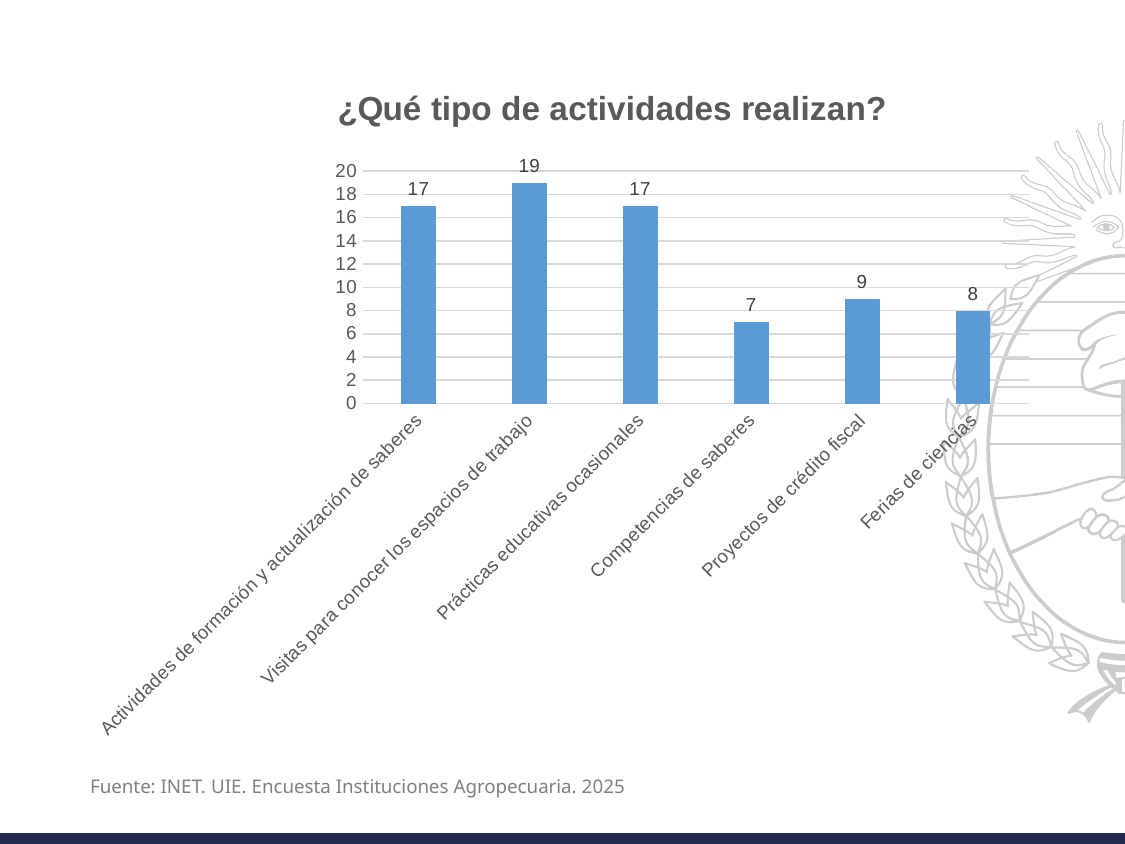
What is the title of the chart? ¿Qué tipo de actividades realizan? What is the value for Visitas para conocer los espacios de trabajo? 19 How many categories are shown in the chart? 6 Which is larger, the value for Proyectos de crédito fiscal or the value for Ferias de ciencias? Proyectos de crédito fiscal What is the value for Proyectos de crédito fiscal? 9 What is the value for Ferias de ciencias? 8 Which category has the highest value? Visitas para conocer los espacios de trabajo Is the value for Prácticas educativas ocasionales greater or less than 10? greater What is the value for Competencias de saberes? 7 What kind of chart is shown on the slide? Bar chart Which category has the lowest value? Competencias de saberes What is the difference between the values for Visitas para conocer los espacios de trabajo and Competencias de saberes? 12